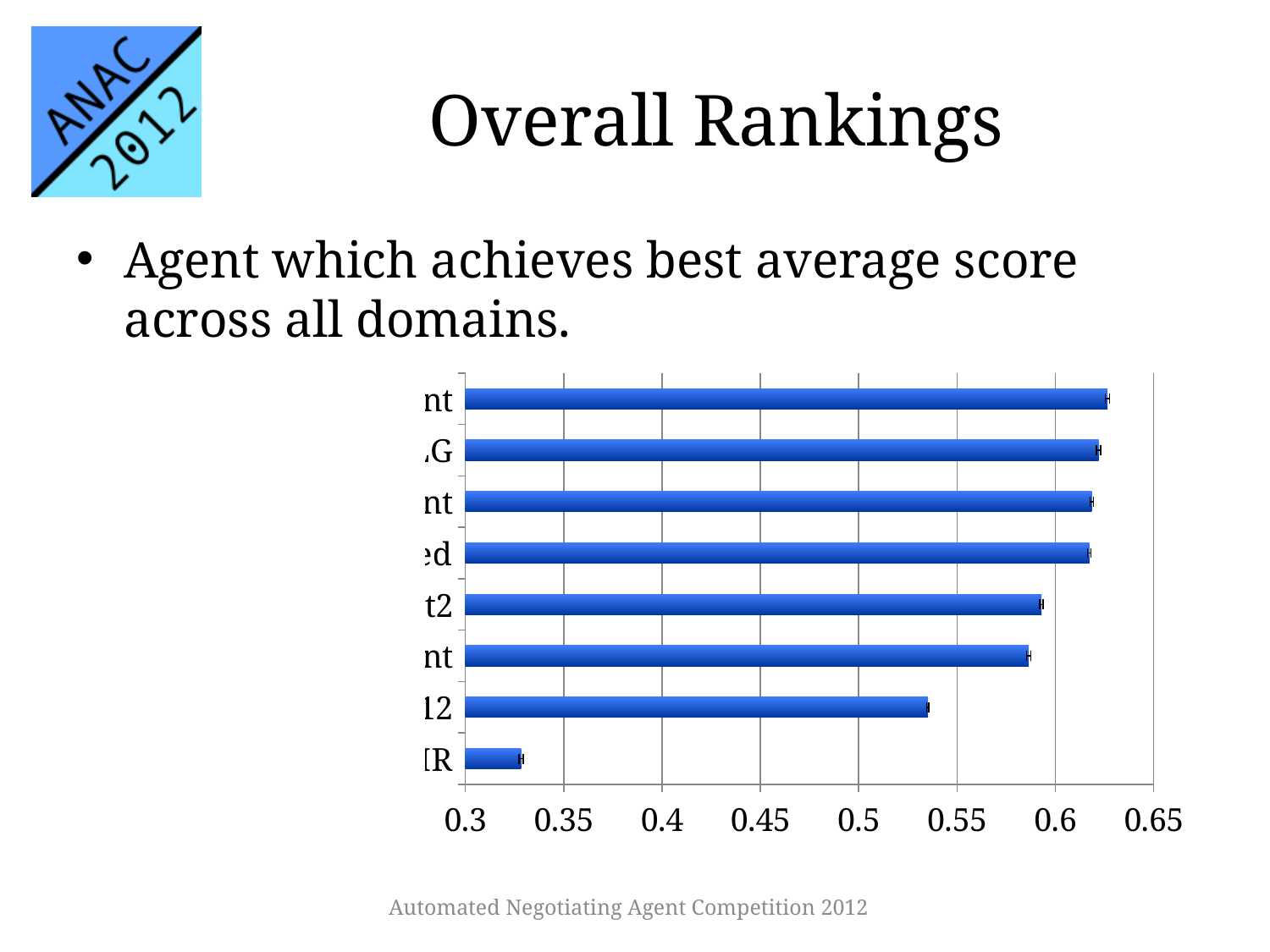
Is the value for the fifth bar from the top greater or less than 0.55? greater Is the value for the second bar from the bottom greater or less than 0.55? less What is the lowest value shown on the horizontal axis? 0.3 Which is larger, the value of the top bar or the value of the bottom bar? the top bar Which bar is the longest in the chart? the top bar Is the value for the bottom bar greater or less than 0.35? less Which bar is the shortest in the chart? the bottom bar What kind of chart is shown on the slide? bar chart What is the highest value shown on the horizontal axis? 0.65 How many bars are plotted in the chart? 8 Do the bar values increase or decrease going from the top bar to the bottom bar? decrease